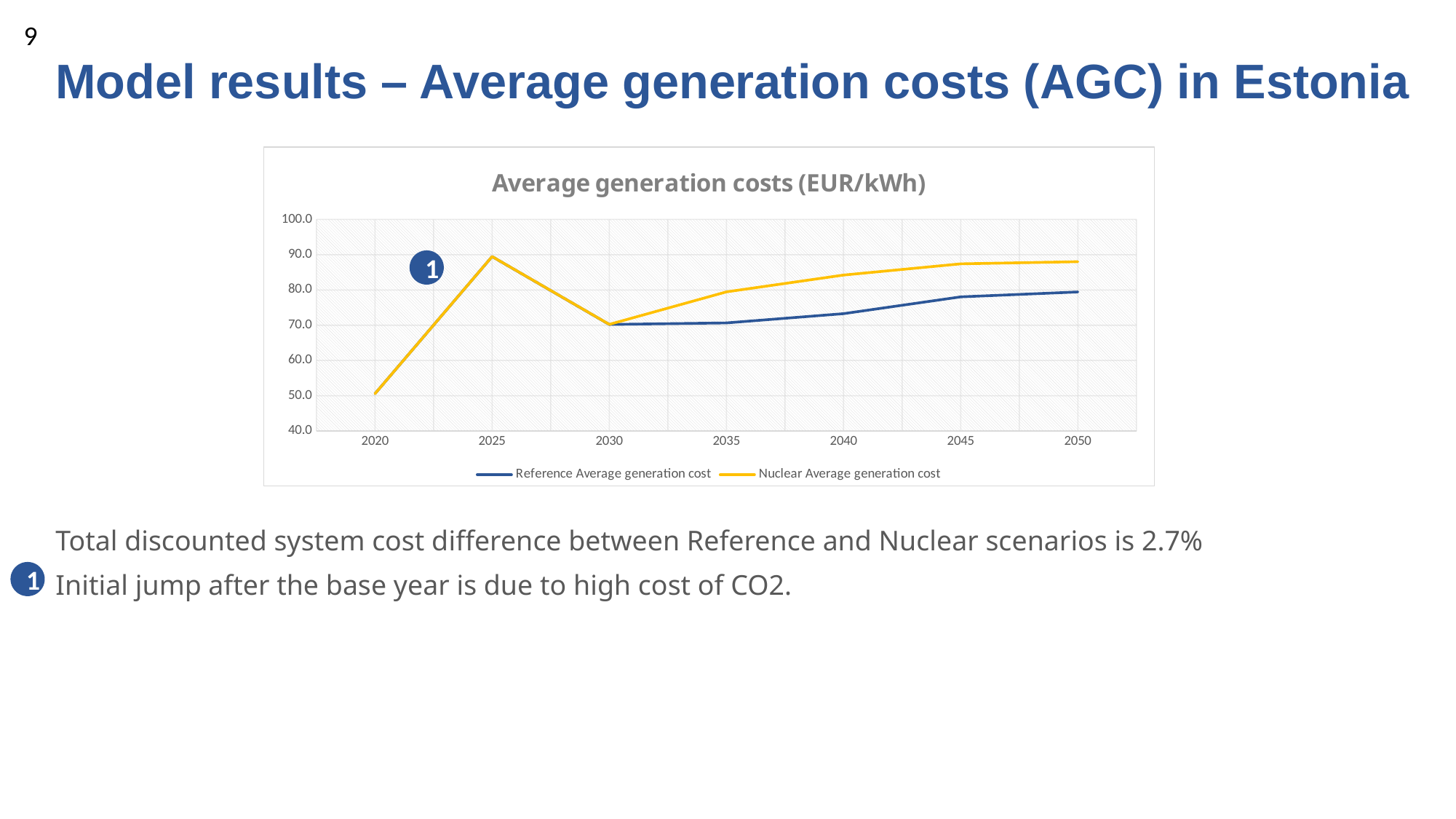
How many years are shown on the x axis of the chart? 7 Is the Nuclear Average generation cost in 2050 greater or less than 80.0? greater What is the title of the chart? Average generation costs (EUR/kWh) What kind of chart is shown on the slide? line chart In 2040, which is larger: the Reference Average generation cost or the Nuclear Average generation cost? Nuclear Average generation cost Does the Reference Average generation cost rise or fall from 2030 to 2050? rise How many series does the legend of the chart list? 2 Is the Reference Average generation cost in 2040 greater or less than 80.0? less Which series is drawn in yellow in the chart? Nuclear Average generation cost In which year is the Reference Average generation cost lowest? 2020 Is the Nuclear Average generation cost in 2025 greater or less than 80.0? greater